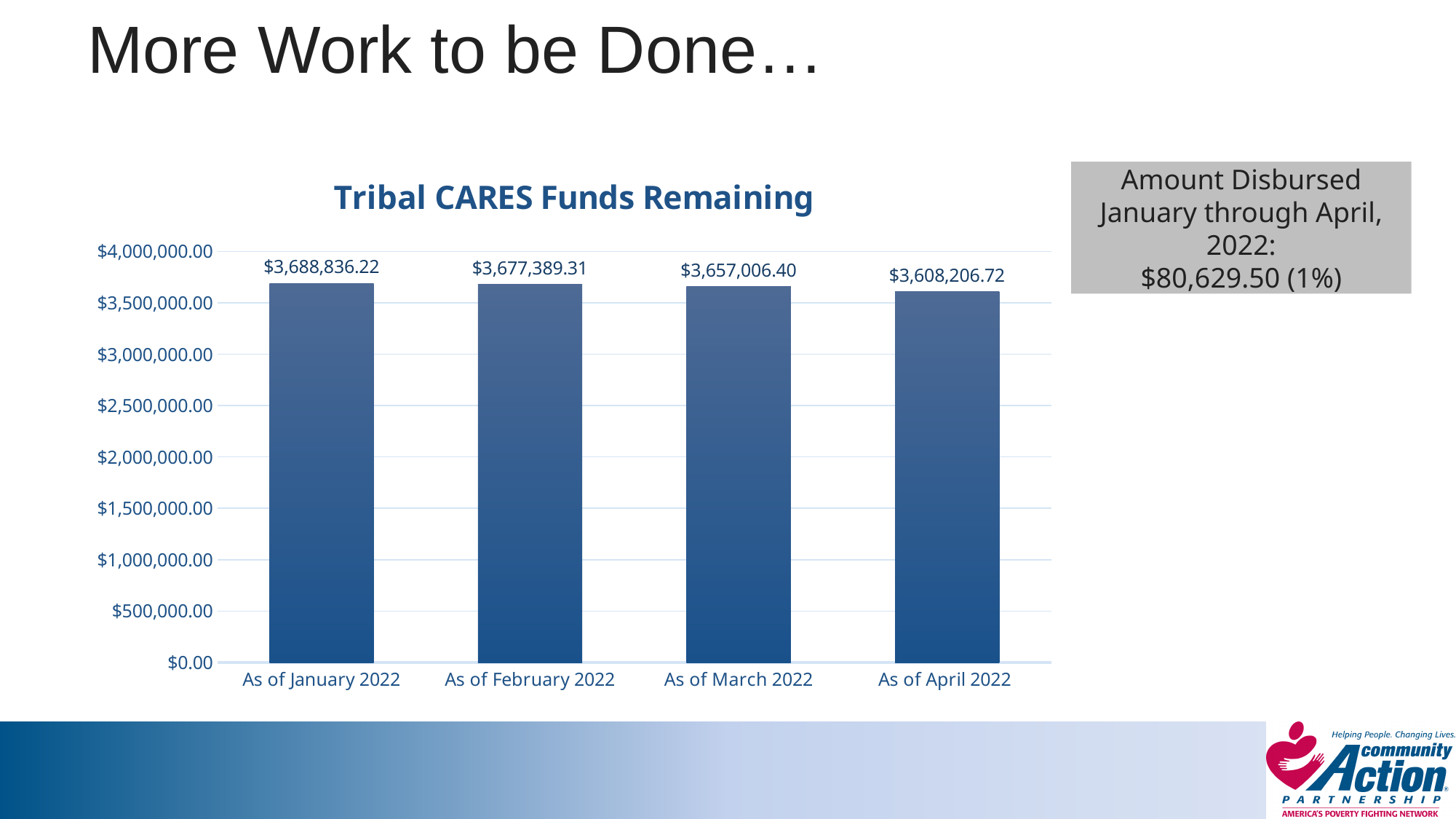
What kind of chart is the Tribal CARES Funds Remaining chart? bar chart What is the value for As of March 2022 in the Tribal CARES Funds Remaining chart? $3,657,006.40 Which category has the lowest value in the Tribal CARES Funds Remaining chart? As of April 2022 Which is larger in the Tribal CARES Funds Remaining chart, the value for As of February 2022 or As of March 2022? As of February 2022 What is the difference between the As of January 2022 and As of April 2022 values in the Tribal CARES Funds Remaining chart? $80,629.50 How many categories are shown in the Tribal CARES Funds Remaining chart? 4 What is the difference between the As of March 2022 and As of April 2022 values in the Tribal CARES Funds Remaining chart? $48,799.68 What is the value for As of January 2022 in the Tribal CARES Funds Remaining chart? $3,688,836.22 Which category has the highest value in the Tribal CARES Funds Remaining chart? As of January 2022 Is the value for As of April 2022 greater or less than $3,500,000.00? greater Do the values in the Tribal CARES Funds Remaining chart rise or fall from January 2022 to April 2022? fall What is the value for As of April 2022 in the Tribal CARES Funds Remaining chart? $3,608,206.72